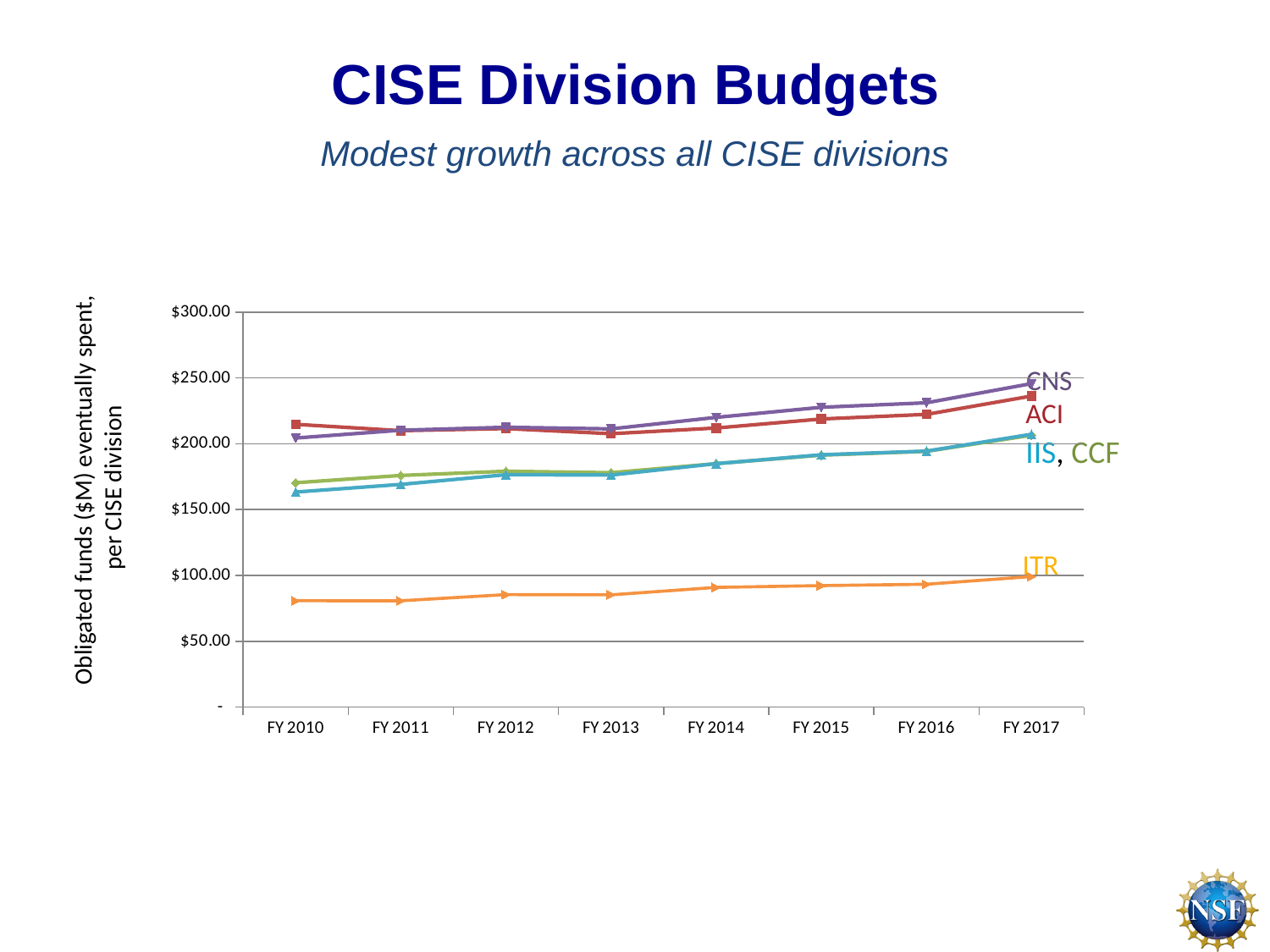
How many fiscal years are shown on the x axis? 8 Is the value for IIS in FY 2010 greater or less than $150.00? greater Which division has the highest value in FY 2010? ACI What kind of chart is shown on the slide? line chart Does the ITR line rise or fall from FY 2010 to FY 2017? rises Which is larger in FY 2014, the value for ACI or the value for ITR? ACI Is the value for CNS in FY 2017 greater or less than $200.00? greater Which division has the lowest value in FY 2017? ITR What is the title of the slide? CISE Division Budgets Is the value for ITR in FY 2010 greater or less than $100.00? less How many division lines are plotted on the chart? 5 Which division has the highest value in FY 2017? CNS